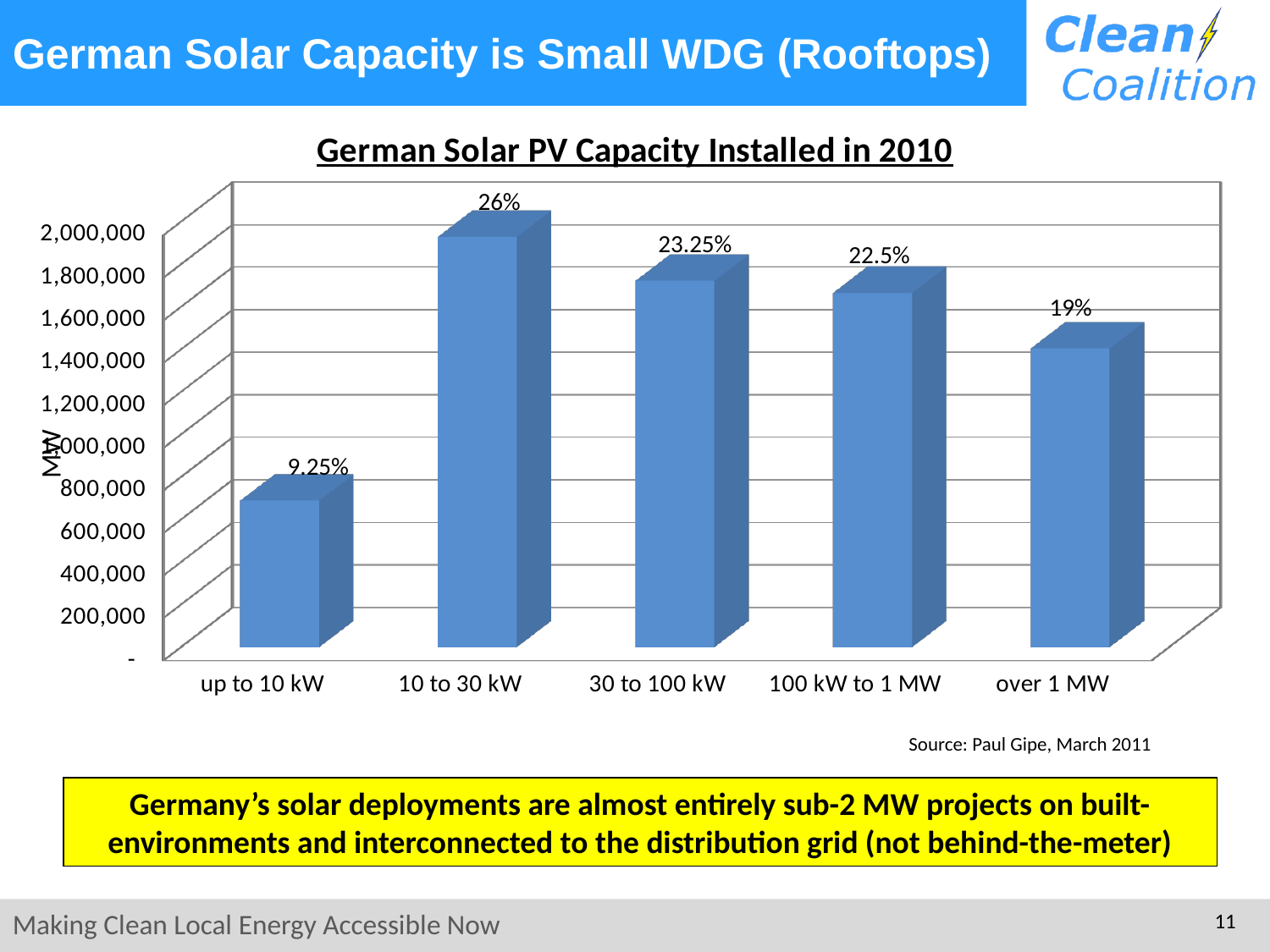
What data label is shown on the bar for 'over 1 MW'? 19% Which category has the highest installed capacity? 10 to 30 kW What type of chart is shown on the slide? Bar chart What data label is shown on the bar for 'up to 10 kW'? 9.25% Is the value for 'up to 10 kW' greater or less than 1,000,000 MW? less What is the difference in percentage points between the labels for '10 to 30 kW' and 'over 1 MW'? 7 percentage points What data label is shown on the bar for '10 to 30 kW'? 26% Which category has the lowest installed capacity? up to 10 kW Is the value for '10 to 30 kW' greater or less than 1,800,000 MW? greater What data label is shown on the bar for '30 to 100 kW'? 23.25% Which has the larger share, '30 to 100 kW' or '100 kW to 1 MW'? 30 to 100 kW How many categories are shown on the x axis? 5